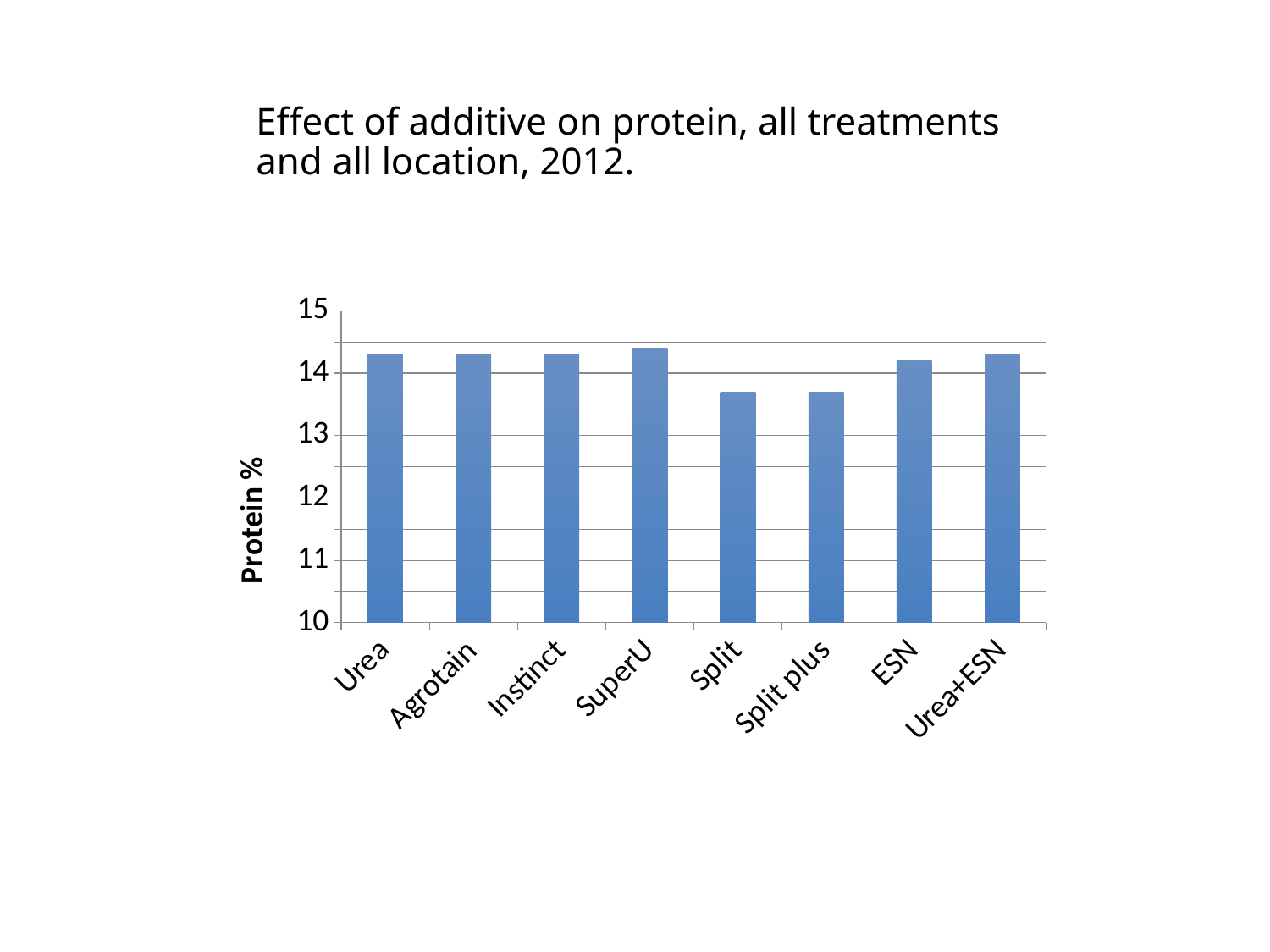
What kind of chart is shown on the slide? bar chart Is the value for SuperU greater or less than 14? greater Is the value for Split greater or less than 14? less What is the label of the vertical axis? Protein % Is the value for Split greater or less than 13? greater Which has the higher protein value, Urea or Split? Urea Which has the higher protein value, Split plus or ESN? ESN How many treatment categories are shown on the x axis? 8 What is the title of the chart? Effect of additive on protein, all treatments and all location, 2012.